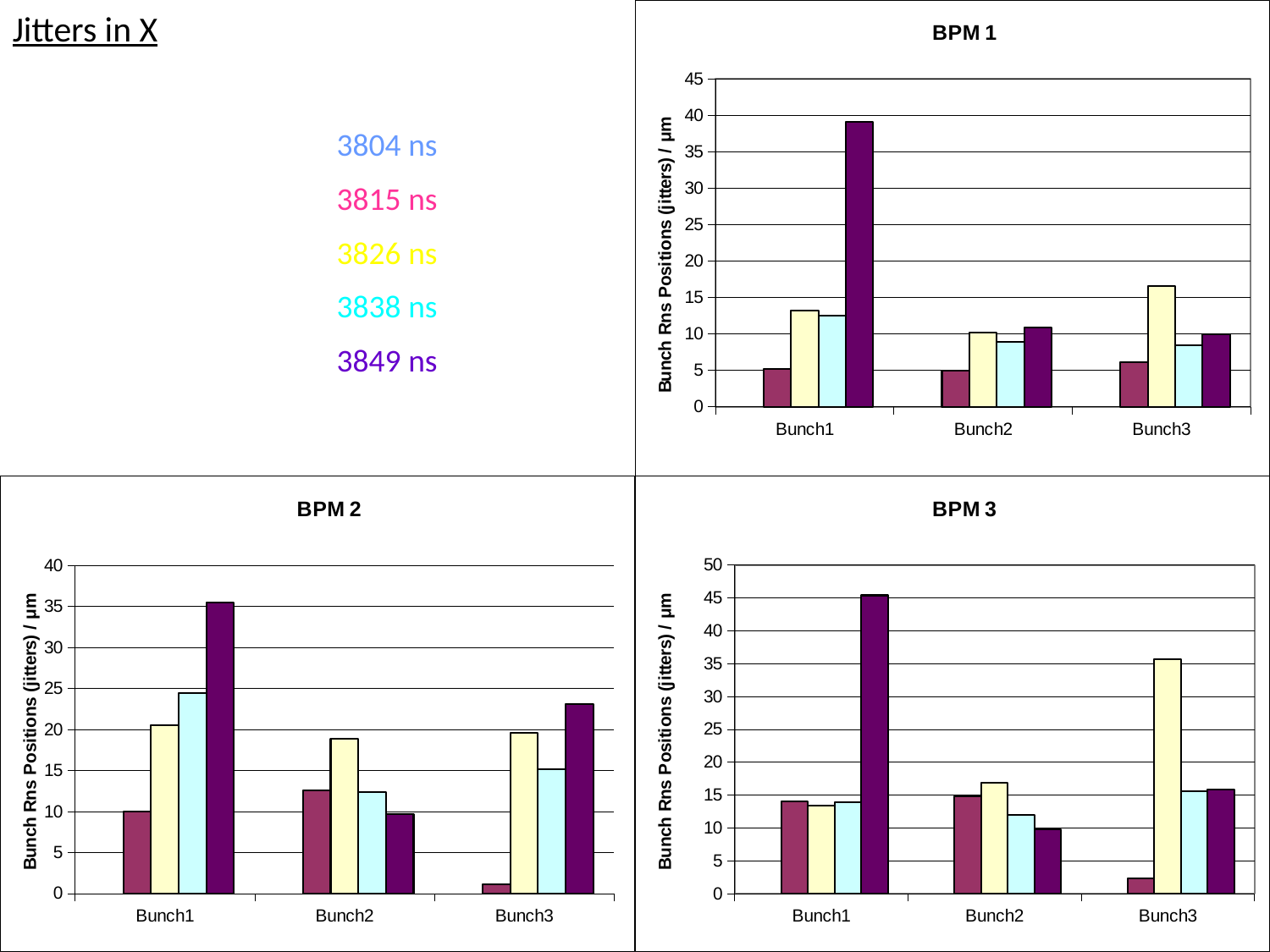
In the BPM 1 chart, is the value of the dark purple bar for Bunch1 greater or less than 35? greater In the BPM 2 chart, for Bunch1, which is larger: the light blue bar or the pale yellow bar? the light blue bar In the BPM 1 chart, is the value of the pale yellow bar for Bunch3 greater or less than 15? greater In the BPM 1 chart, which category contains the tallest bar? Bunch1 In the BPM 3 chart, is the value of the dark red bar for Bunch3 greater or less than 5? less What kind of chart is the BPM 3 chart? bar chart What is the y-axis title of the BPM 1 chart? Bunch Rns Positions (jitters) / µm In the BPM 3 chart, for Bunch2, which is larger: the pale yellow bar or the dark purple bar? the pale yellow bar How many categories are shown on the x axis of the BPM 2 chart? 3 In the BPM 2 chart, which category contains the shortest bar? Bunch3